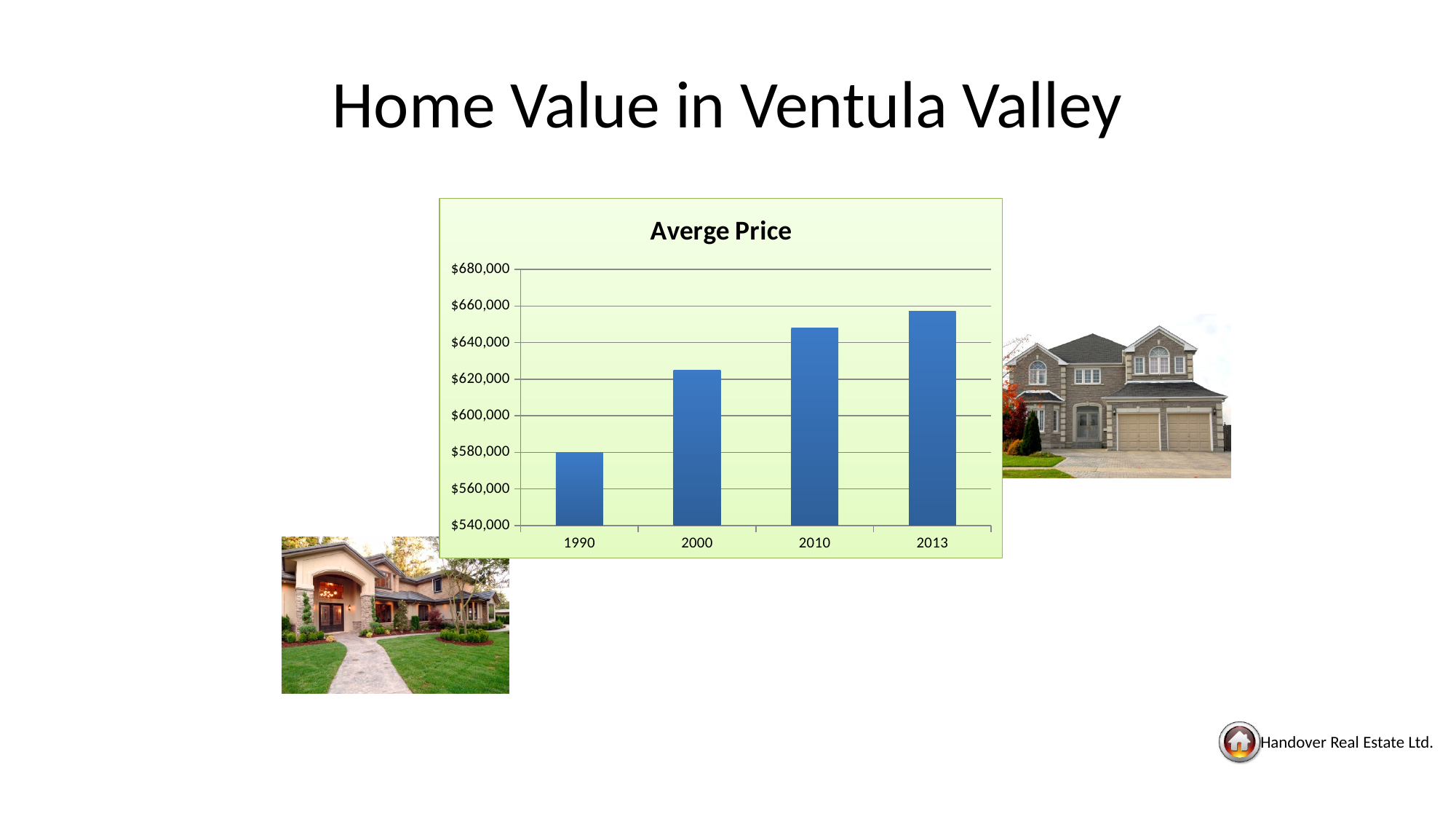
Which year has a higher average price, 2000 or 2010? 2010 Which year has the highest average price? 2013 How many years are shown on the x axis of the chart? 4 Do the average prices rise or fall from 1990 to 2013? Rise Is the average price for 2000 greater or less than $640,000? less Which year has the lowest average price? 1990 Is the average price for 2013 greater or less than $660,000? less What is the title of the chart? Averge Price Is the average price for 1990 greater or less than $600,000? less What kind of chart is shown on the slide? Bar chart What is the highest value shown on the y axis of the chart? $680,000